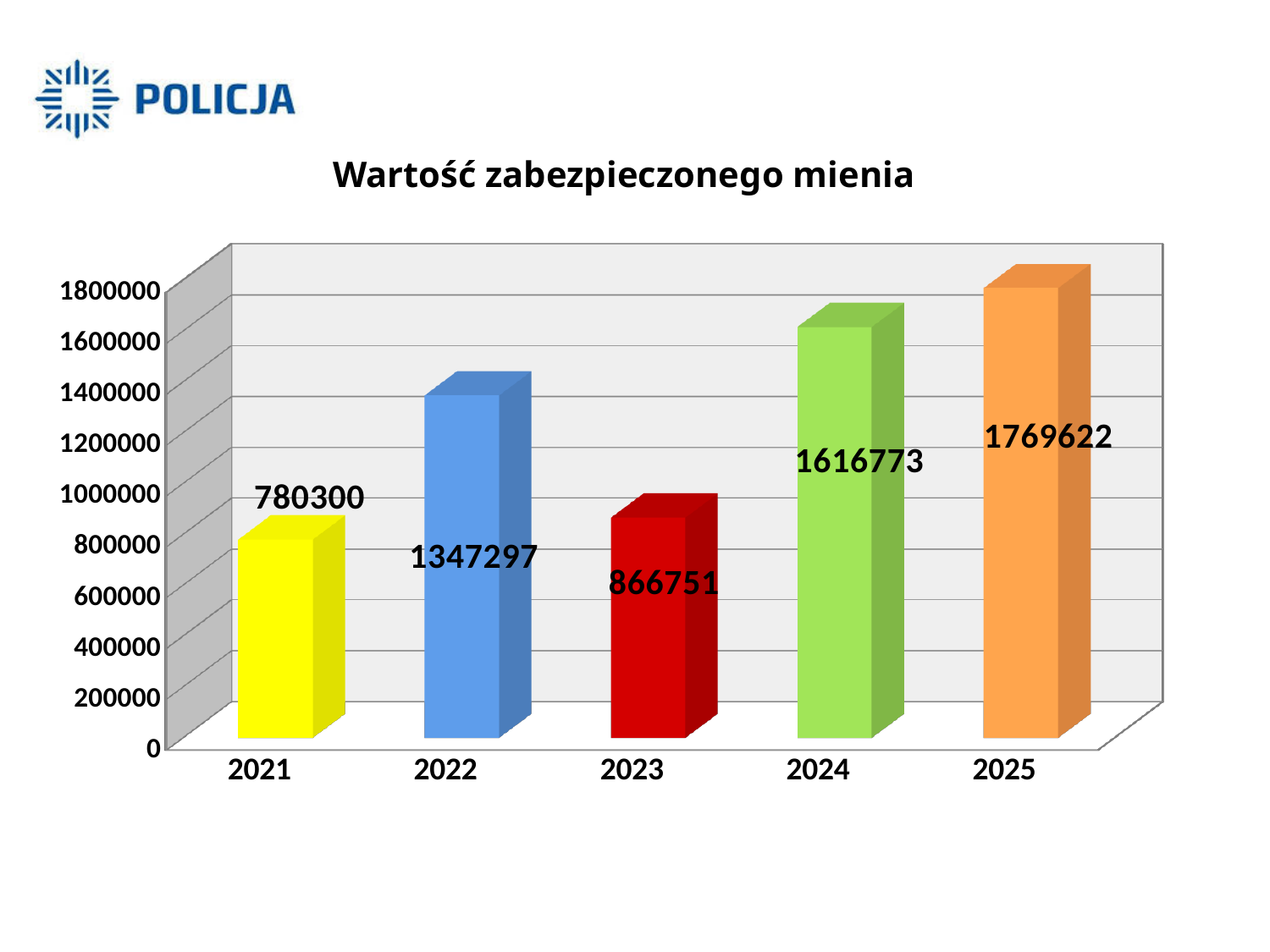
What is the value for 2021? 780300 What is the difference between the values for 2025 and 2024? 152849 What kind of chart is shown on the slide? bar chart Which year has the highest value? 2025 Which is larger, the value for 2022 or the value for 2023? 2022 How many years are shown on the chart? 5 What is the title of the chart? Wartość zabezpieczonego mienia What is the value for 2024? 1616773 What is the value for 2023? 866751 What is the value for 2025? 1769622 Which year has the lowest value? 2021 What is the value for 2022? 1347297